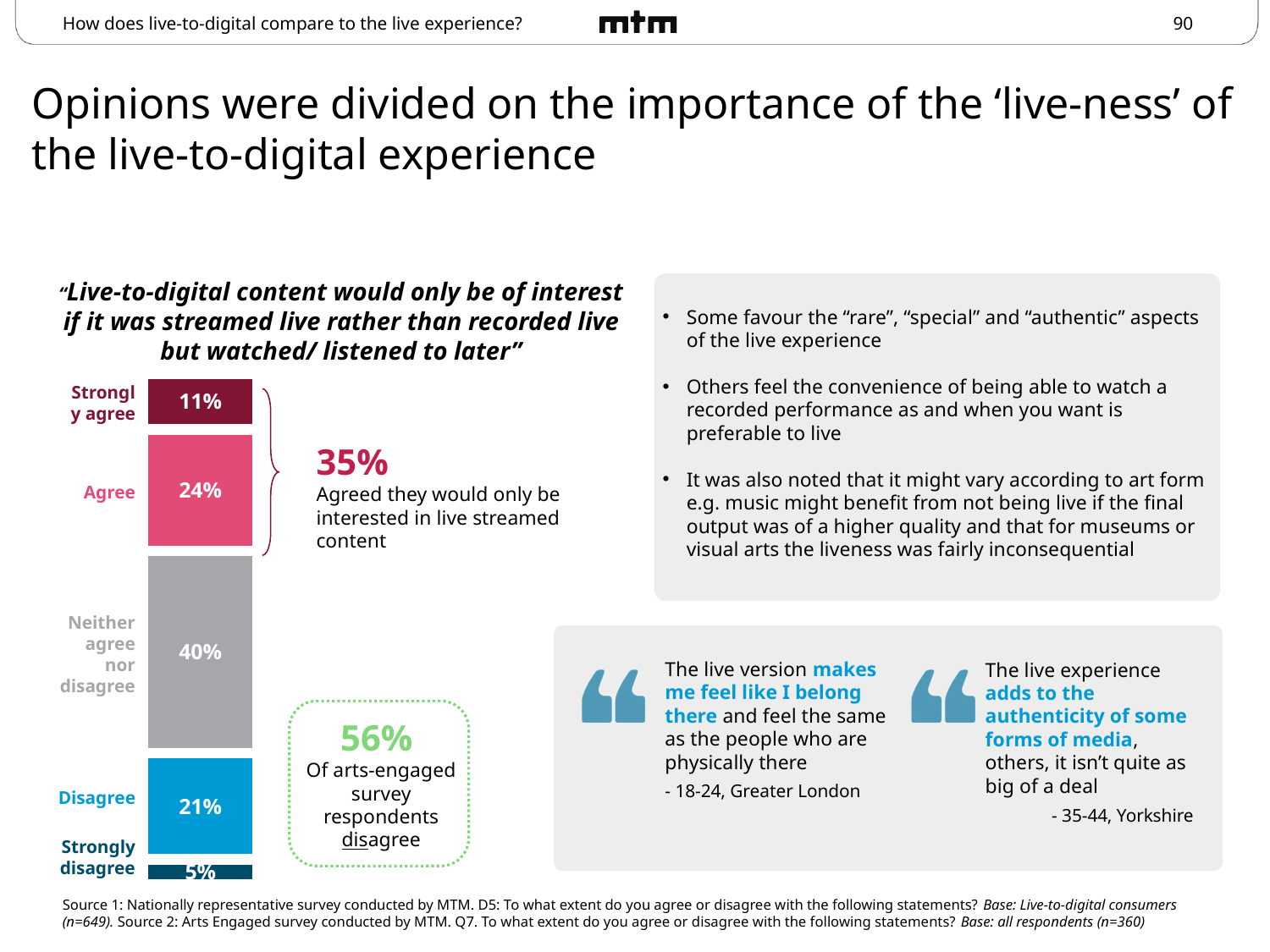
Which is larger, the share who agree or the share who disagree? Agree What percentage of respondents strongly disagree? 5% What percentage of respondents disagree with the statement? 21% What percentage of respondents strongly agree that live-to-digital content would only be of interest if streamed live? 11% What combined percentage is shown for those who agreed they would only be interested in live streamed content? 35% Which response category has the smallest share? Strongly disagree What percentage of respondents neither agree nor disagree? 40% What percentage of respondents agree with the statement? 24% How many response categories are shown in the chart? 5 What is the difference between the Neither agree nor disagree share and the Agree share? 16% What kind of chart is used to show the responses? Stacked bar chart Which response category has the largest share? Neither agree nor disagree